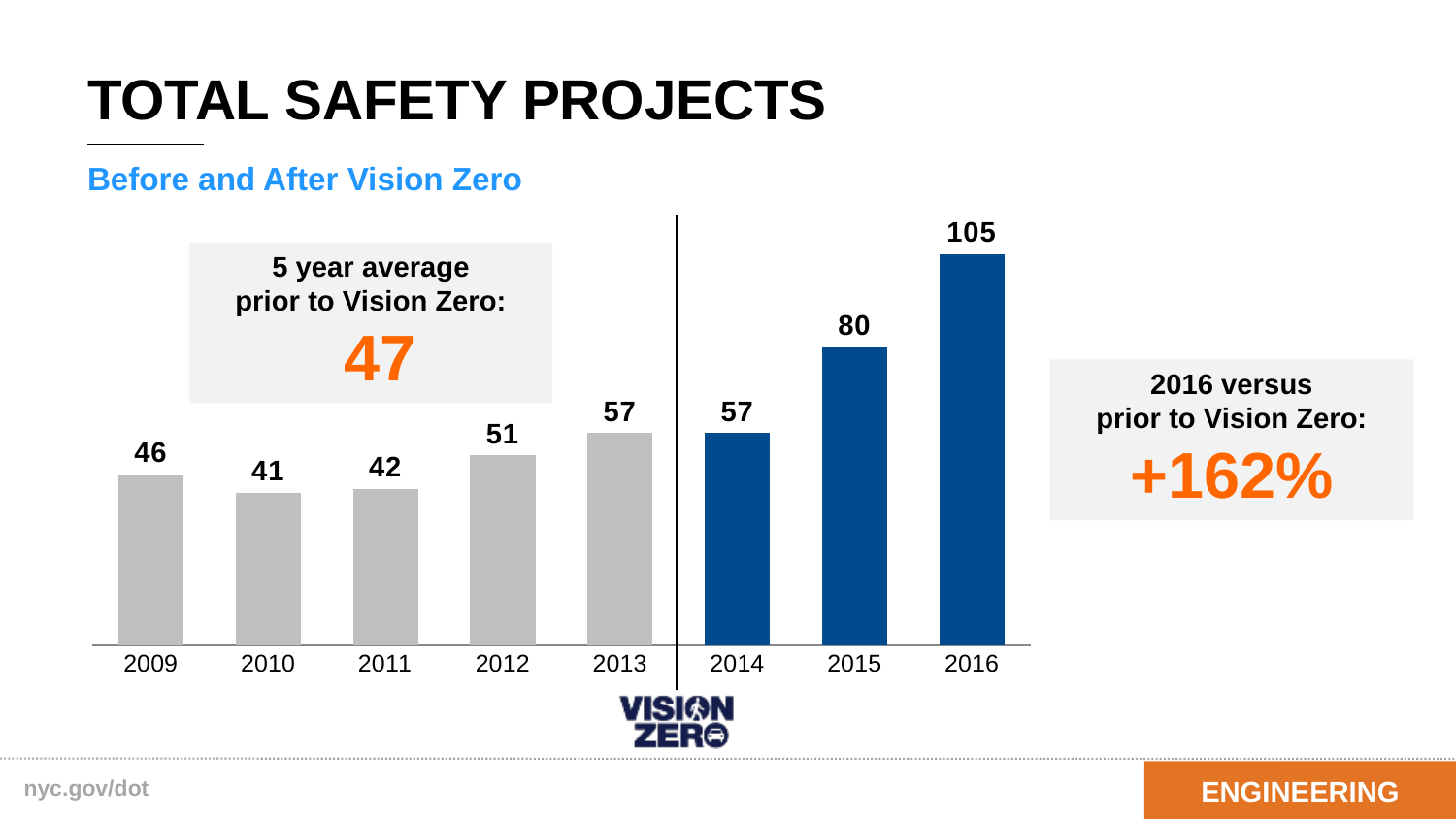
What is the value for 2010? 41 Which year has the lowest value? 2010 Which year has the highest value? 2016 What is the difference between the values for 2012 and 2011? 9 What is the 5 year average prior to Vision Zero shown on the slide? 47 Which is larger, the value for 2009 or the value for 2013? 2013 How many years are shown on the x axis? 8 What is the difference between the values for 2016 and 2014? 48 What is the value for 2015? 80 Do the values rise or fall from 2014 to 2016? rise What is the value for 2016? 105 What kind of chart is this? bar chart